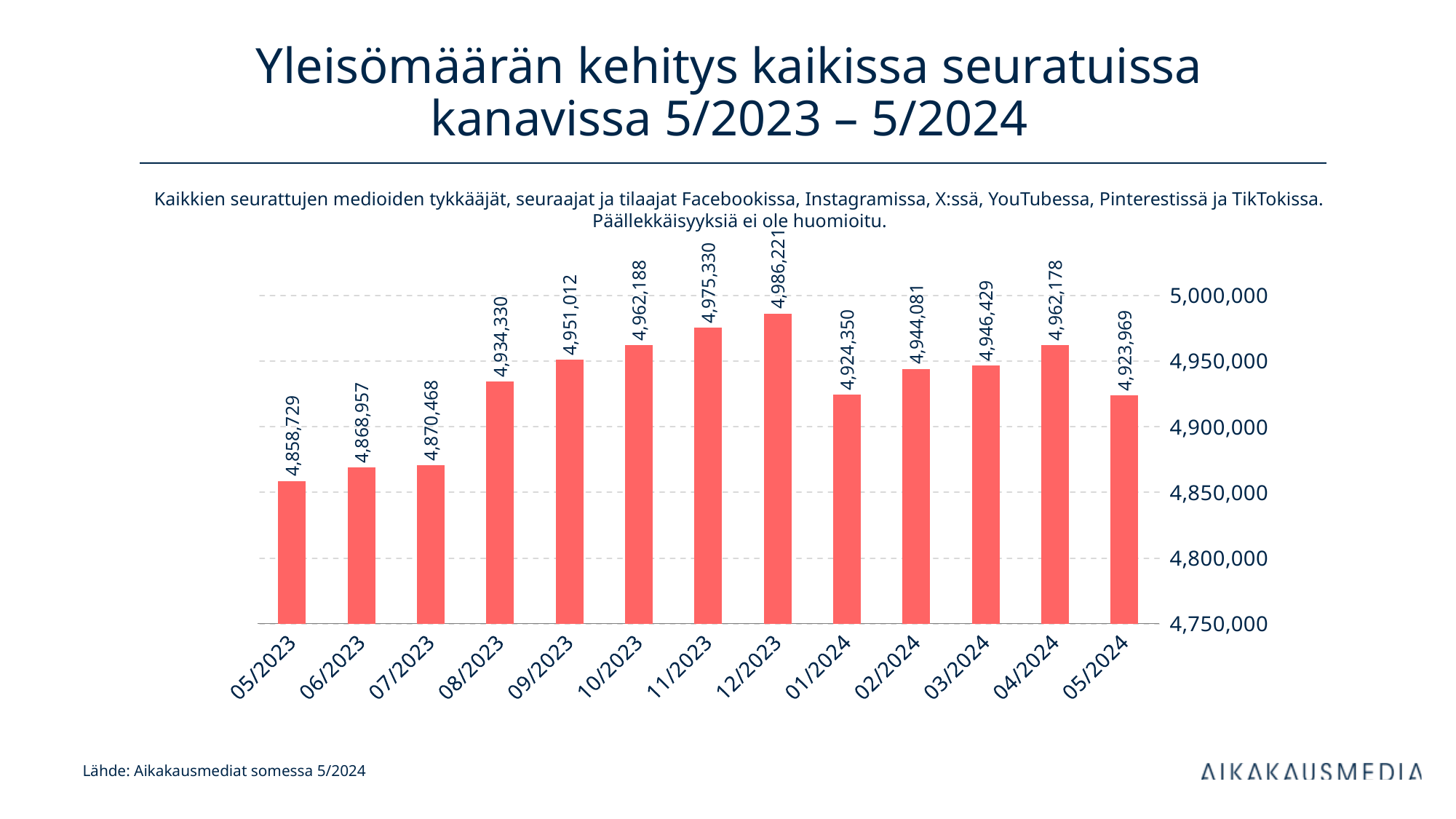
Do the values rise or fall from 05/2023 to 12/2023? rise What is the difference between the values for 05/2024 and 05/2023? 65,240 How many months are shown on the x axis? 13 Which month has the highest value? 12/2023 Is the value for 12/2023 greater or less than 4,950,000? greater Which is larger, the value for 09/2023 or the value for 01/2024? 09/2023 What is the value for 12/2023? 4,986,221 Which month has the lowest value? 05/2023 What kind of chart is shown on the slide? bar chart What is the difference between the values for 12/2023 and 01/2024? 61,871 What is the value for 01/2024? 4,924,350 What is the value for 05/2023? 4,858,729